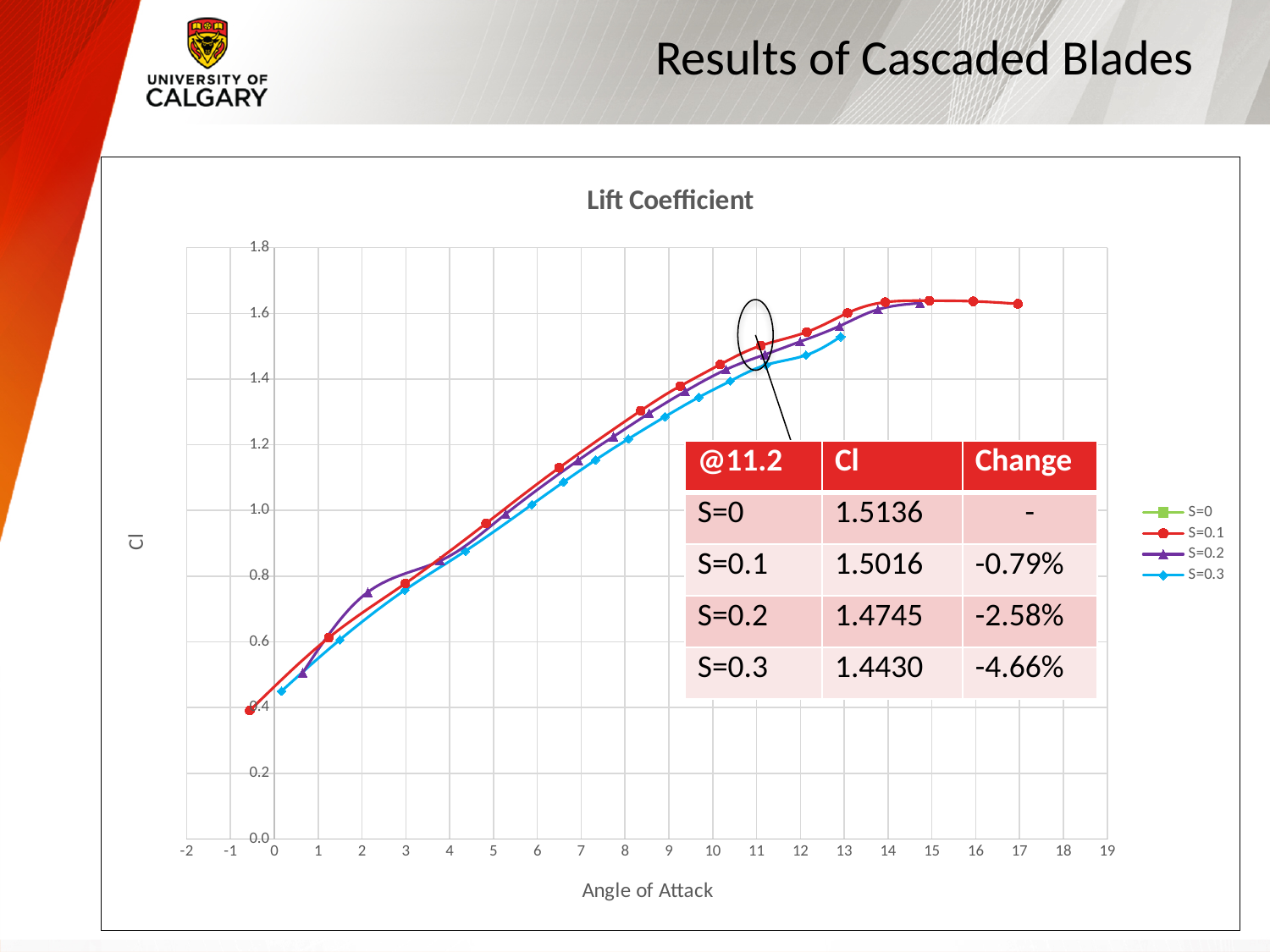
Is the Cl value for the S=0.3 series at an angle of attack of 13 greater or less than 1.4? greater At an angle of attack of 11.2, which series has the lowest Cl value in the table? S=0.3 According to the table on the chart, what is the Cl value for S=0.3 at an angle of attack of 11.2? 1.4430 What is the difference between the Cl values for S=0 and S=0.3 at 11.2, as given in the table? 0.0706 At an angle of attack of 11.2, which series has the highest Cl value in the table? S=0 According to the table on the chart, what is the Cl value for S=0.1 at an angle of attack of 11.2? 1.5016 According to the table on the chart, what is the percentage change in Cl for S=0.2 at 11.2? -2.58% How many series does the chart legend list? 4 What is the title of the chart? Lift Coefficient Does the Cl value for the S=0.1 series generally rise or fall as the angle of attack increases from 0 to 14? rise What kind of chart is shown on the slide? line chart What is the label of the x axis? Angle of Attack